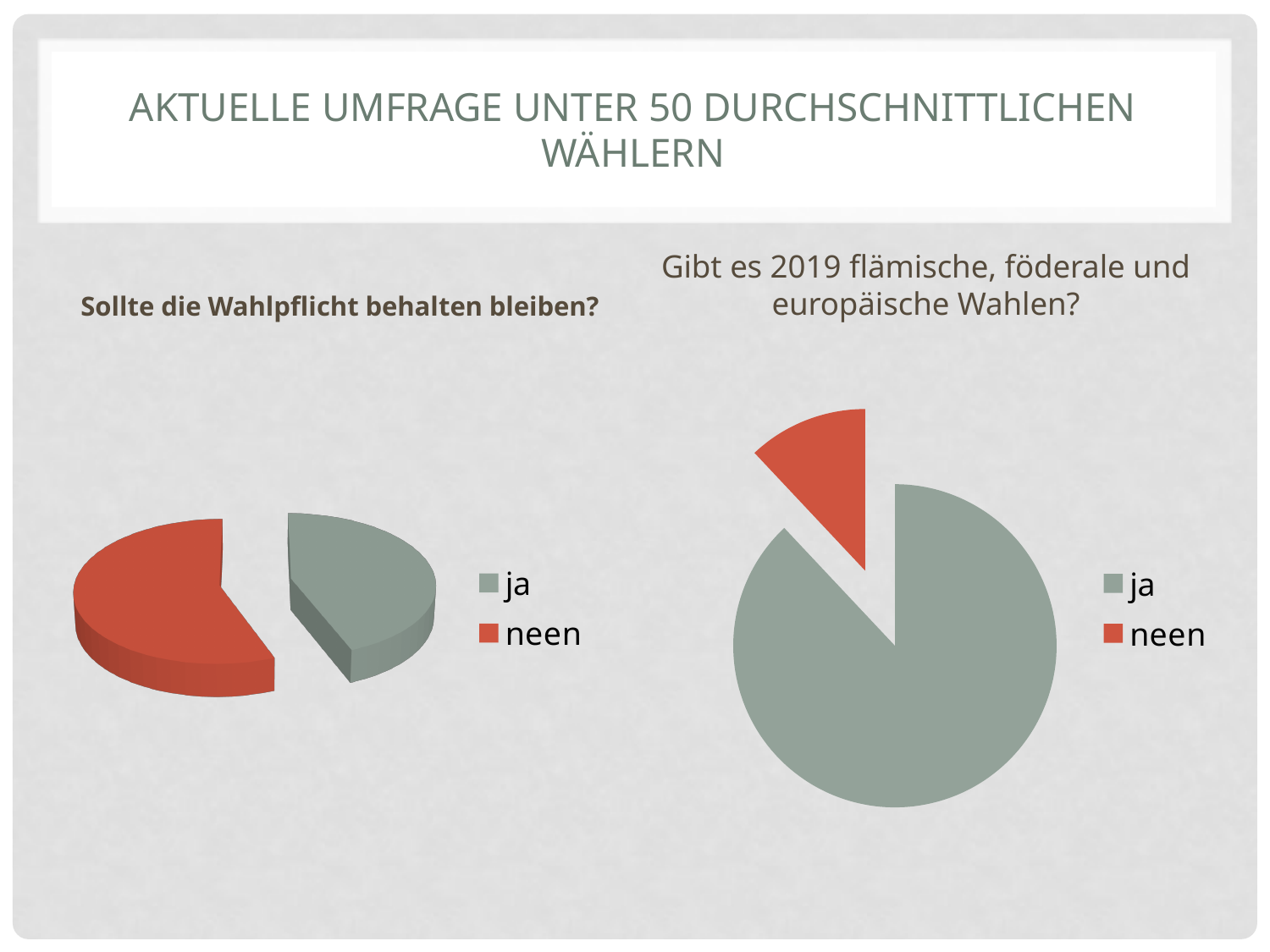
In the right chart "Gibt es 2019 flämische, föderale und europäische Wahlen?", which slice is the smallest? neen In the right chart "Gibt es 2019 flämische, föderale und europäische Wahlen?", which slice is the largest? ja In the right chart "Gibt es 2019 flämische, föderale und europäische Wahlen?", is the "ja" slice larger or smaller than the "neen" slice? larger In the left chart "Sollte die Wahlpflicht behalten bleiben?", is the "ja" slice larger or smaller than the "neen" slice? smaller In the left chart "Sollte die Wahlpflicht behalten bleiben?", which slice is the largest? neen What kind of chart is the left chart titled "Sollte die Wahlpflicht behalten bleiben?"? pie chart In the left chart "Sollte die Wahlpflicht behalten bleiben?", which slice is the smallest? ja In the right chart "Gibt es 2019 flämische, föderale und europäische Wahlen?", what colour is the "neen" slice? red In the right chart "Gibt es 2019 flämische, föderale und europäische Wahlen?", how many slices does the pie have? 2 In the left chart "Sollte die Wahlpflicht behalten bleiben?", how many entries does the legend list? 2 What kind of chart is the right chart titled "Gibt es 2019 flämische, föderale und europäische Wahlen?"? pie chart What are the two legend entries of the left chart "Sollte die Wahlpflicht behalten bleiben?"? ja, neen